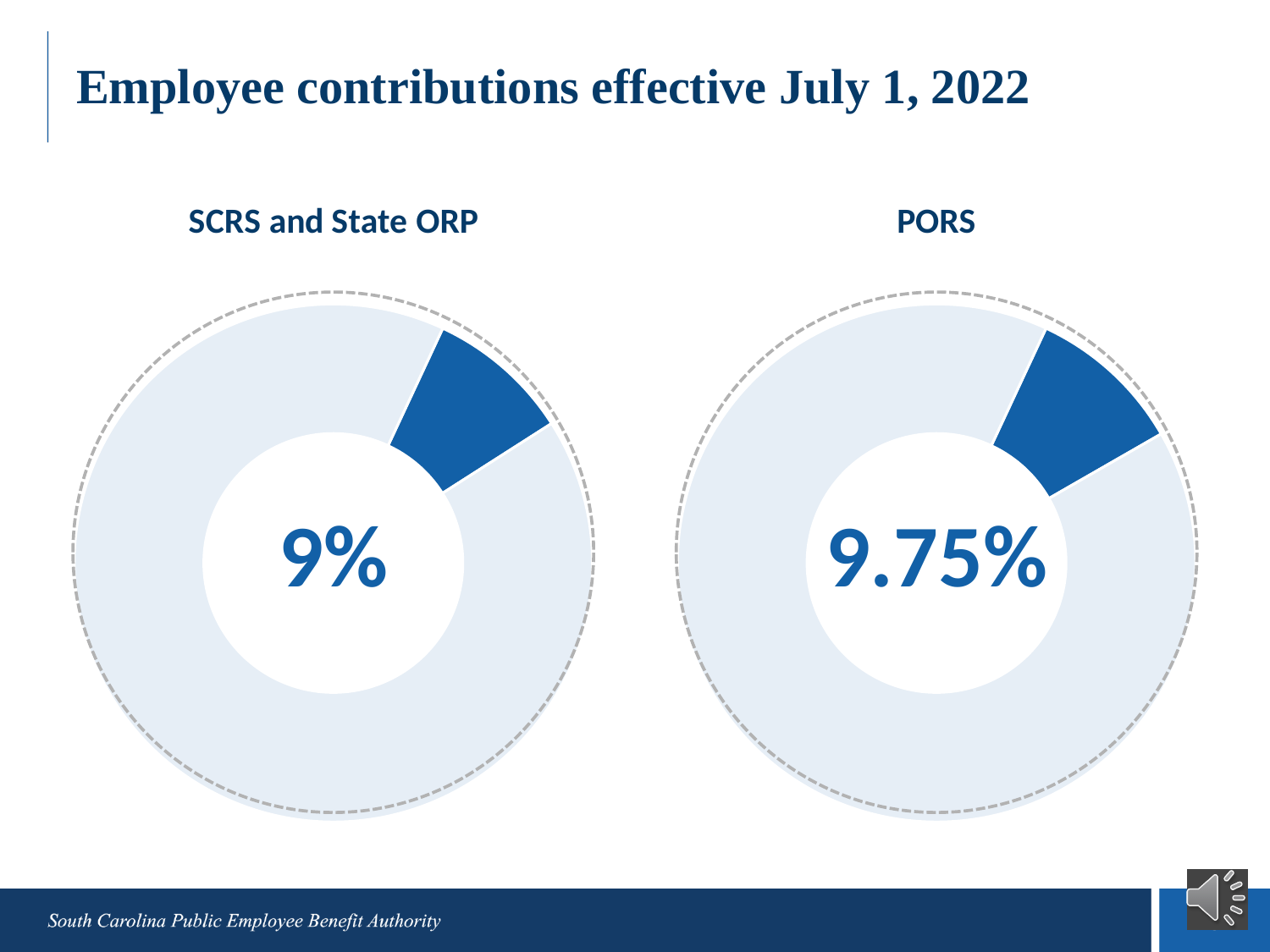
What kind of chart is used to show the SCRS and State ORP contribution rate? Donut (pie) chart In the SCRS and State ORP chart, what employee contribution rate is shown? 9% Which plan shows the higher employee contribution rate, SCRS and State ORP or PORS? PORS What is the label above the chart on the right side of the slide? PORS Which plan shows the lower employee contribution rate, SCRS and State ORP or PORS? SCRS and State ORP In the PORS chart, what share of the ring does the dark blue slice represent? 9.75% How many charts are shown on the slide? 2 What is the difference between the PORS contribution rate and the SCRS and State ORP contribution rate? 0.75% In the SCRS and State ORP chart, what share of the ring does the dark blue slice represent? 9% In the PORS chart, what employee contribution rate is shown? 9.75% What is the title of the slide containing the two charts? Employee contributions effective July 1, 2022